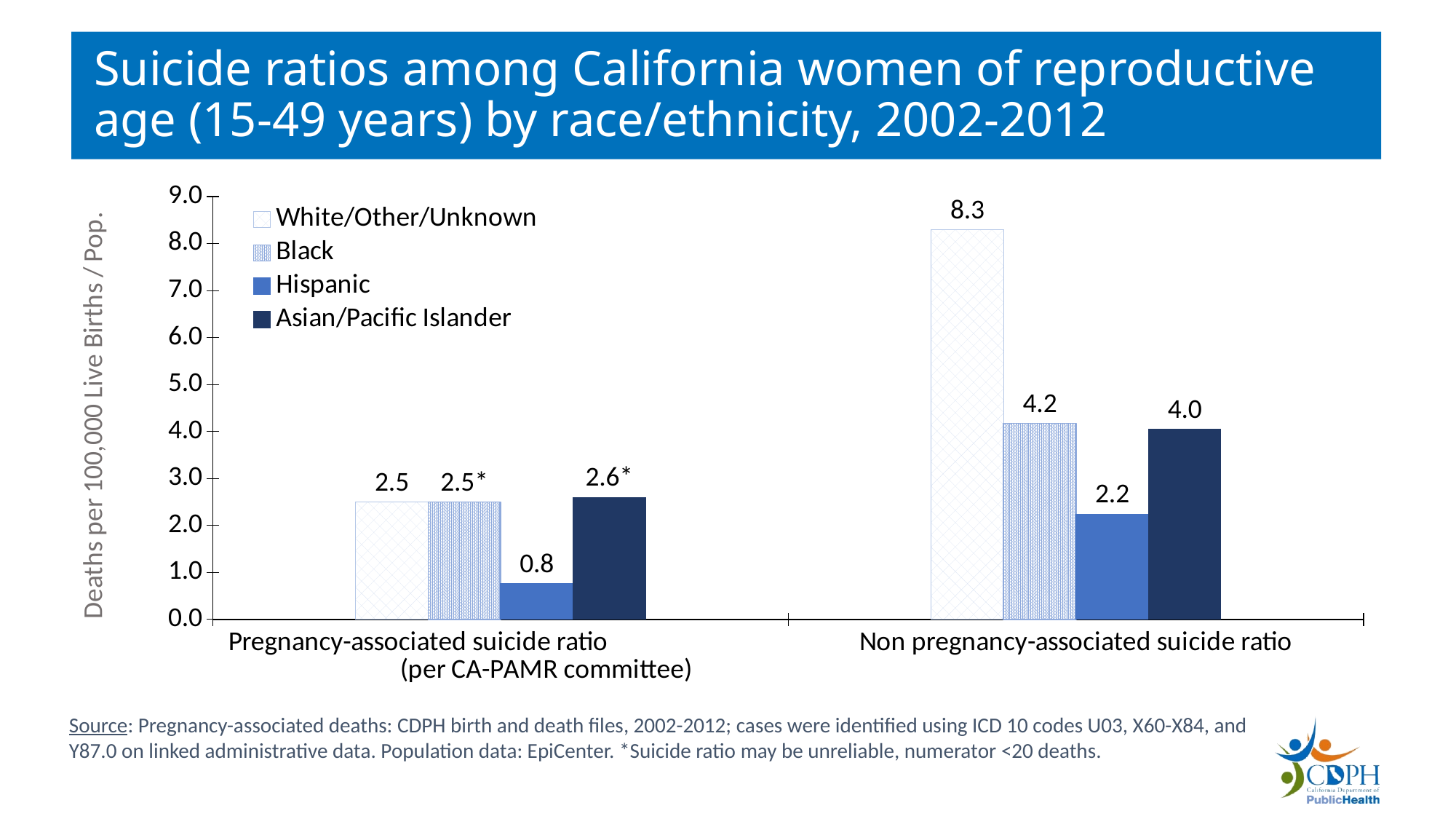
Which is larger: the non pregnancy-associated suicide ratio for Black women or for Asian/Pacific Islander women? Black What is the non pregnancy-associated suicide ratio for White/Other/Unknown women? 8.3 What is the pregnancy-associated suicide ratio for Hispanic women? 0.8 Which race/ethnicity group has the lowest pregnancy-associated suicide ratio? Hispanic What is the non pregnancy-associated suicide ratio for Asian/Pacific Islander women? 4.0 Which race/ethnicity group has the highest non pregnancy-associated suicide ratio? White/Other/Unknown What is the label of the y axis? Deaths per 100,000 Live Births / Pop. What kind of chart is shown on the slide? Bar chart Is the non pregnancy-associated suicide ratio for White/Other/Unknown women greater or less than 8.0? greater How many categories are shown on the x axis? 2 How many series does the legend list? 4 What is the difference between the non pregnancy-associated suicide ratio for Black women and for Hispanic women? 2.0